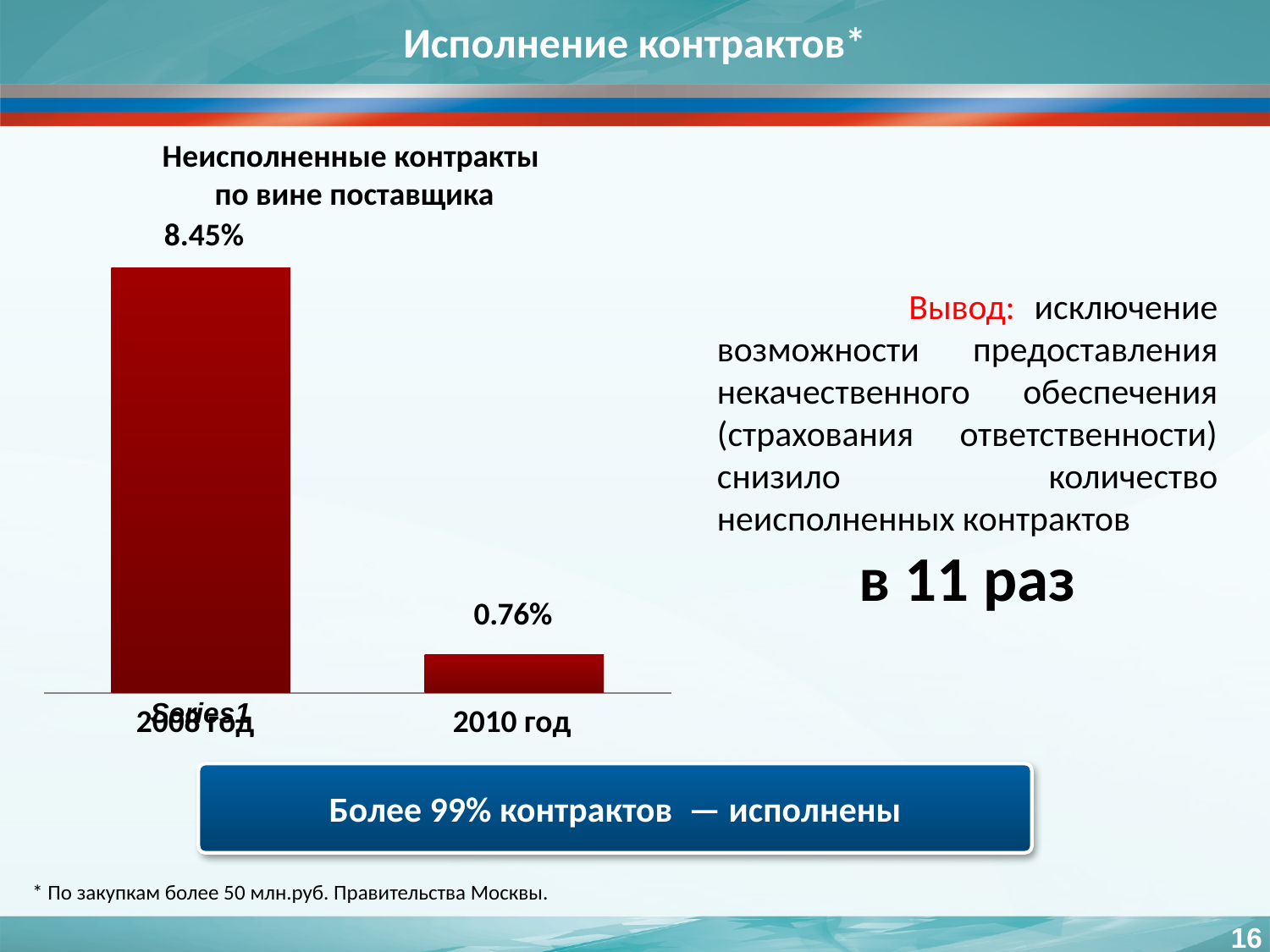
What is the difference between the values for 2008 год and 2010 год? 7.69% Which is larger, the value for 2008 год or the value for 2010 год? 2008 год What colour are the bars in the chart? dark red How many bars are plotted in the chart? 2 What is the value shown for the left bar (2008 год)? 8.45% What is the value shown for 2010 год? 0.76% What is the title of the chart? Неисполненные контракты по вине поставщика Do the values rise or fall from 2008 год to 2010 год? fall Which category has the highest value? 2008 год What type of chart is shown on the slide? bar chart Which category has the lowest value? 2010 год